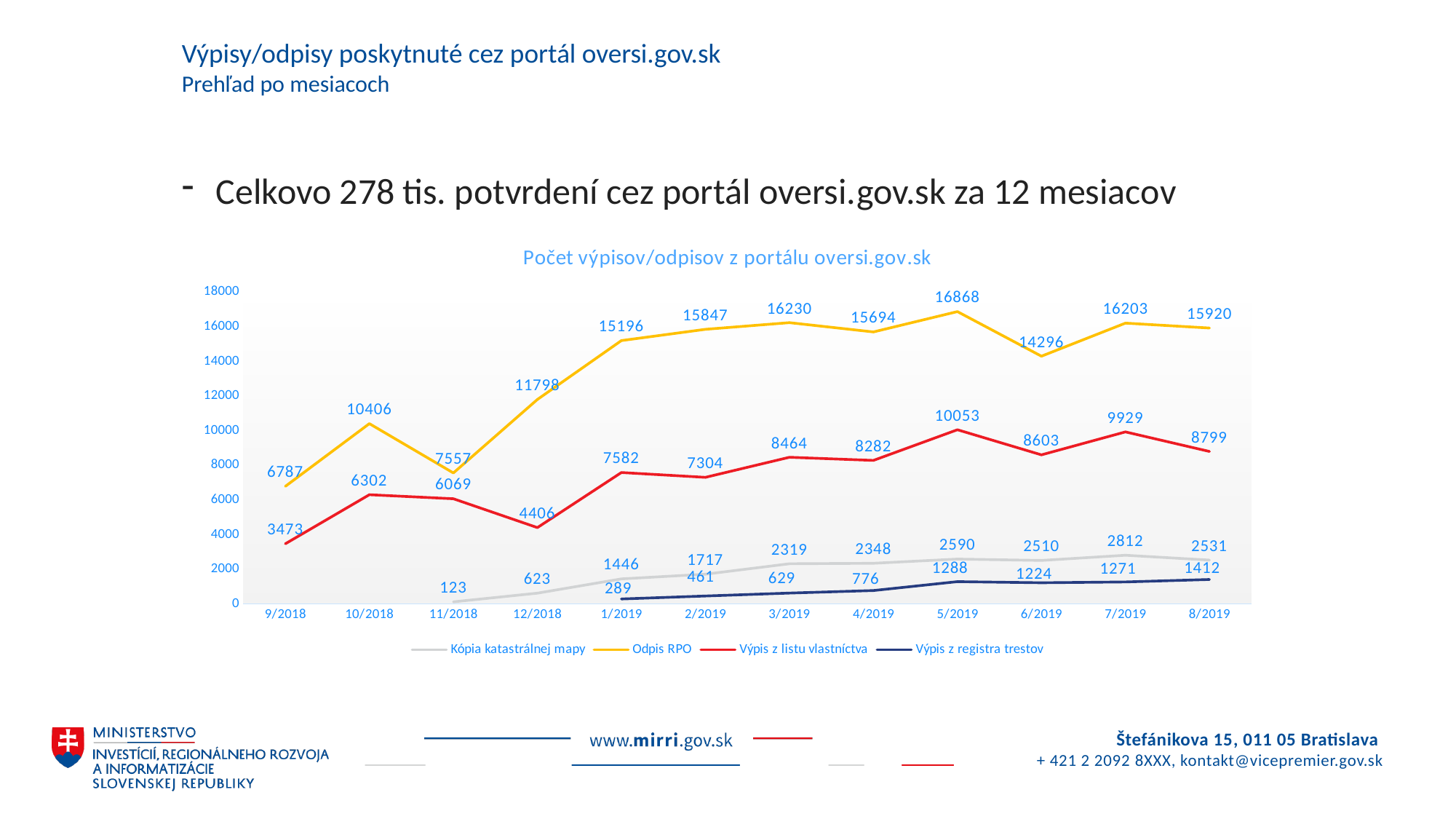
What is the value for Kópia katastrálnej mapy in 11/2018? 123 How many series does the legend list? 4 Which is larger in 10/2018: Odpis RPO or Výpis z listu vlastníctva? Odpis RPO What is the value for Výpis z registra trestov in 8/2019? 1412 What is the value for Odpis RPO in 5/2019? 16868 What type of chart is shown on the slide? line chart What is the difference between Odpis RPO and Výpis z listu vlastníctva in 8/2019? 7121 In which month is Výpis z listu vlastníctva lowest? 9/2018 What is the value for Výpis z listu vlastníctva in 1/2019? 7582 What is the title of the chart? Počet výpisov/odpisov z portálu oversi.gov.sk In which month does Odpis RPO reach its highest value? 5/2019 How many months are shown on the x axis? 12